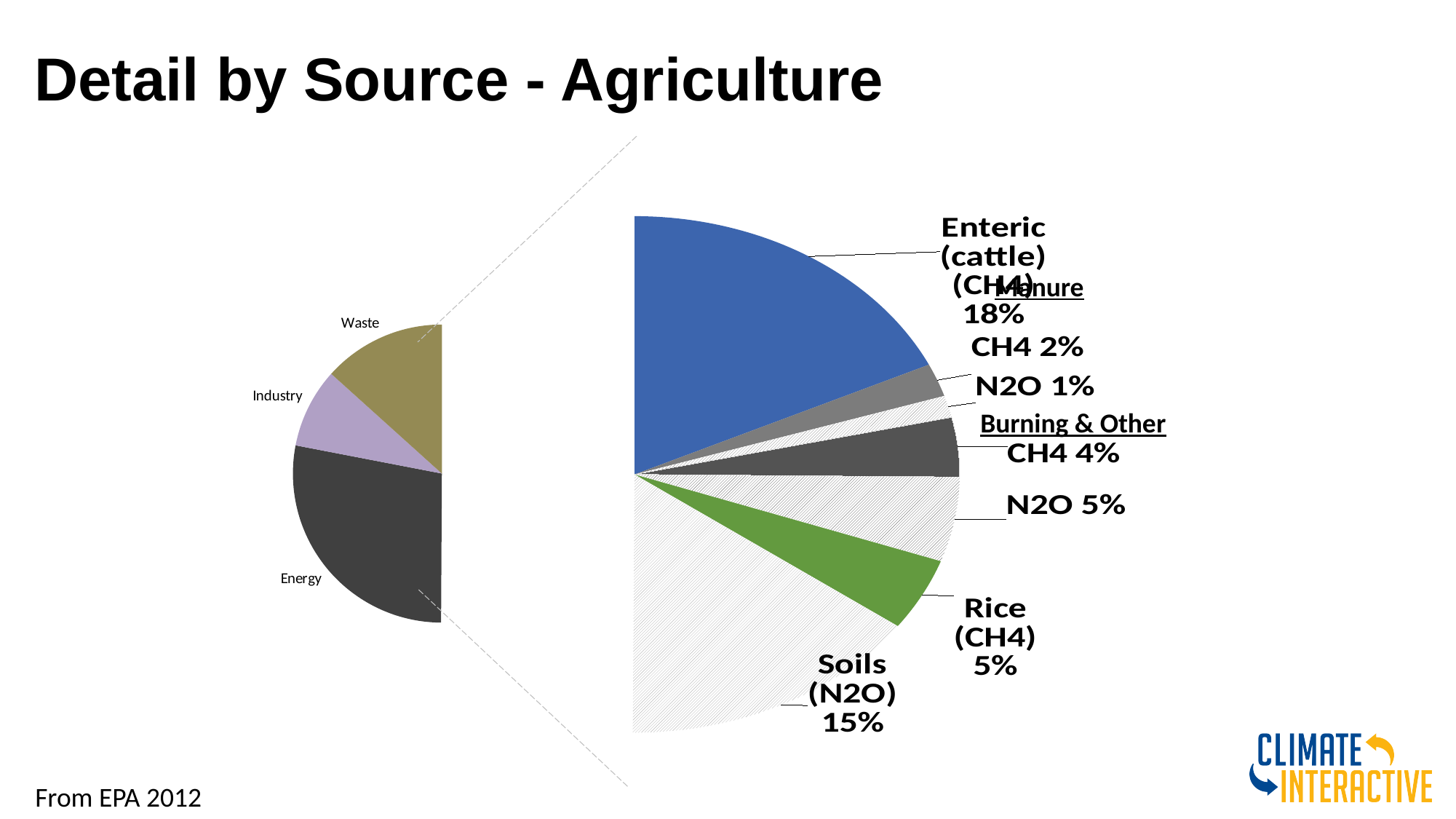
In the large agriculture pie chart, what percentage is shown for Soils (N2O)? 15% What are the three labelled categories in the small pie chart on the left of the slide? Waste, Industry, Energy In the large agriculture pie chart, which is larger: Burning & Other CH4 or Burning & Other N2O? Burning & Other N2O In the large agriculture pie chart, what percentage is shown for Burning & Other CH4? 4% In the large agriculture pie chart, what percentage is shown for Manure CH4? 2% In the large agriculture pie chart, what percentage is shown for Manure N2O? 1% What kind of chart is the large chart on the right of the slide? Pie chart In the large agriculture pie chart, what percentage is shown for Enteric (cattle) (CH4)? 18% In the large agriculture pie chart, what percentage is shown for Rice (CH4)? 5% In the large agriculture pie chart, which labelled slice has the lowest percentage? Manure N2O In the large agriculture pie chart, what is the difference in percentage points between Enteric (cattle) (CH4) and Soils (N2O)? 3 In the large agriculture pie chart, which labelled slice has the highest percentage? Enteric (cattle) (CH4)